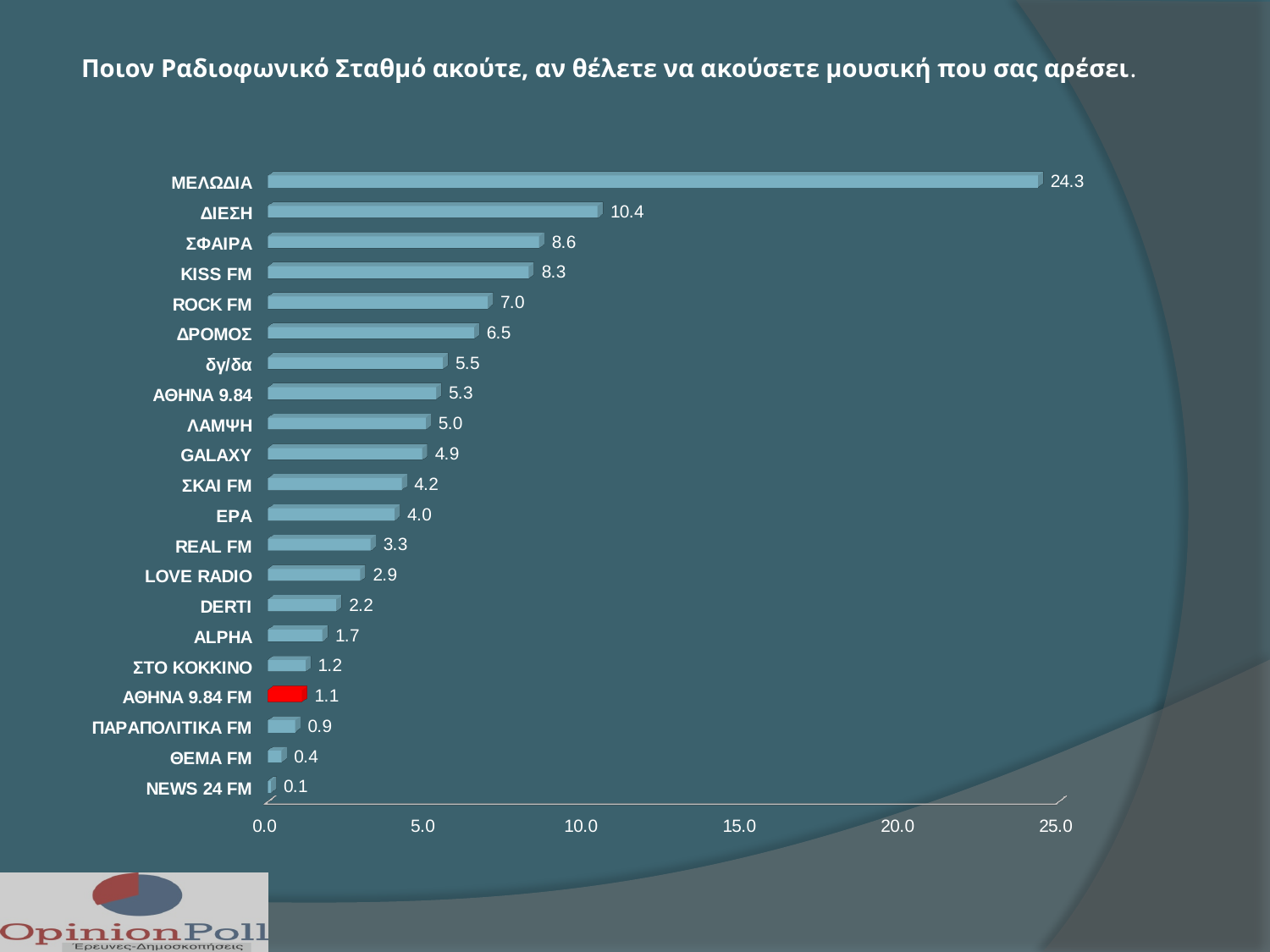
What is the value for LOVE RADIO? 2.9 Which radio station's bar is coloured red? ΑΘΗΝΑ 9.84 FM Which radio station has the lowest value? NEWS 24 FM How many radio stations are shown in the chart? 21 What is the value for ΜΕΛΩΔΙΑ? 24.3 Which radio station has the highest value? ΜΕΛΩΔΙΑ Which has a larger value, ΣΦΑΙΡΑ or GALAXY? ΣΦΑΙΡΑ What is the difference between the values for ΜΕΛΩΔΙΑ and ΔΙΕΣΗ? 13.9 What is the difference between the values for ROCK FM and ΔΡΟΜΟΣ? 0.5 What kind of chart is shown on the slide? bar chart Is the value for ΔΙΕΣΗ greater or less than 10.0? greater What is the value for KISS FM? 8.3